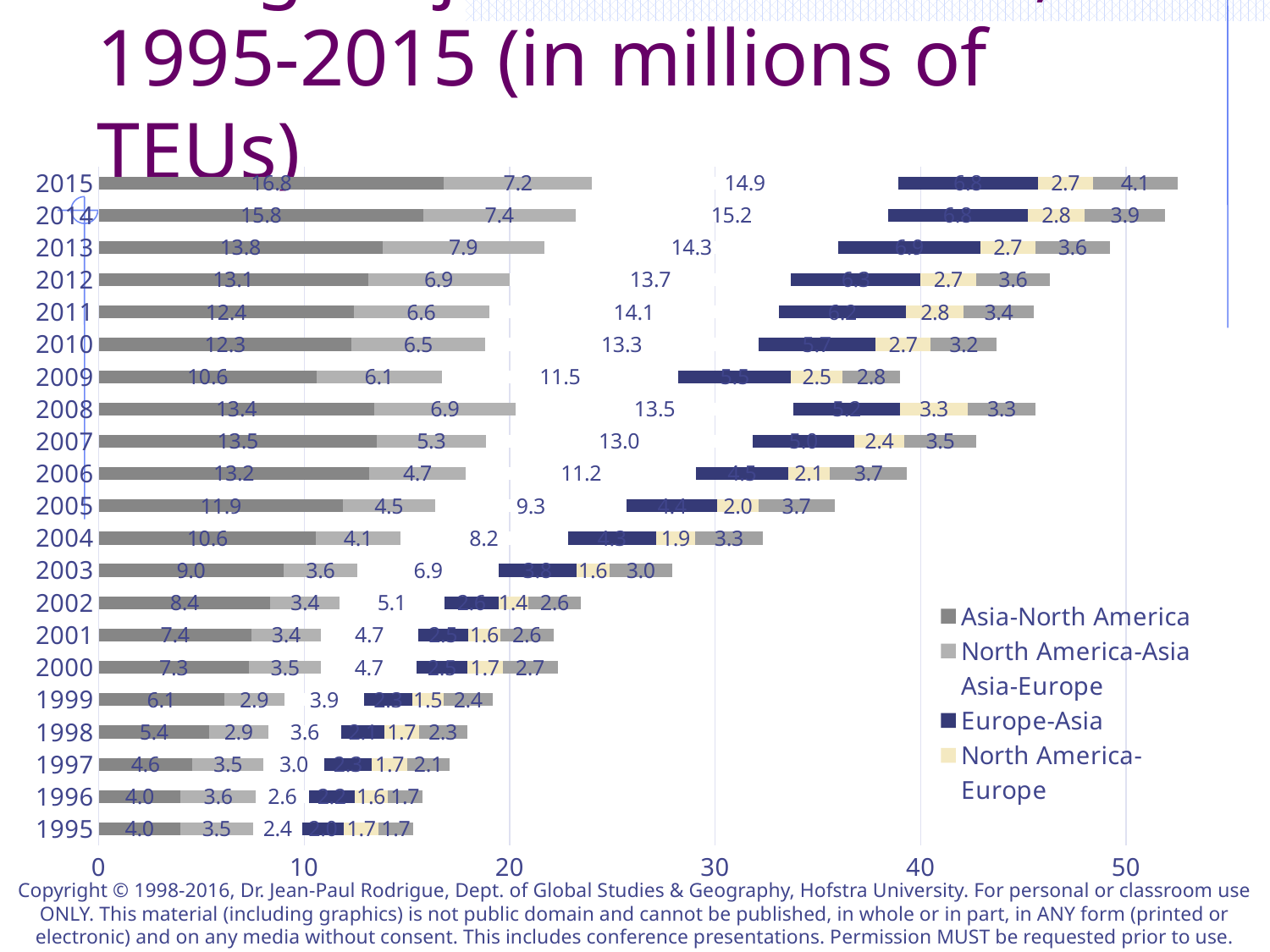
What is the North America-Europe value for 2008? 3.3 What is the Asia-North America value for 1995? 4.0 Which year has the lowest Asia-Europe value? 1995 What is the Asia-Europe value for 2009? 11.5 What kind of chart is shown on the slide? Stacked bar chart What is the North America-Asia value for 2015? 7.2 What is the Asia-Europe value for 2014? 15.2 Which year has the larger Asia-Europe value, 2008 or 2009? 2008 What is the Asia-North America value for 2015? 16.8 How many years are shown on the chart? 21 Which year has the highest Asia-North America value? 2015 By how much did the Asia-North America value change from 2014 to 2015? 1.0